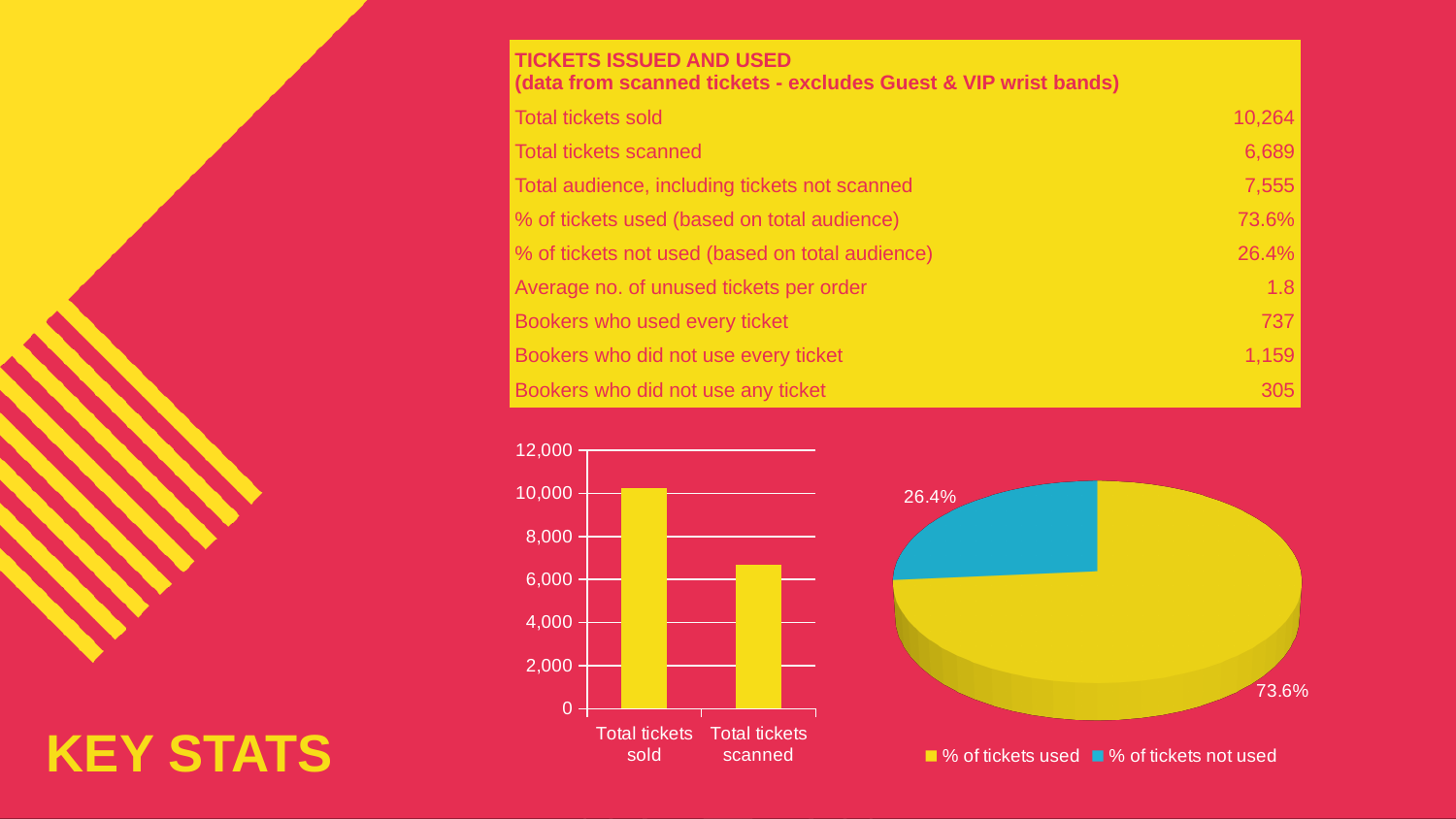
In the bar chart, is the value for Total tickets scanned greater or less than 6,000? greater In the pie chart, how many entries does the legend list? 2 In the bar chart, is the value for Total tickets sold greater or less than 10,000? greater In the pie chart, what colour is the slice for % of tickets not used? blue In the bar chart, which category has the higher value? Total tickets sold In the bar chart, which category has the lower value? Total tickets scanned In the pie chart, what share is labelled for % of tickets not used? 26.4% In the bar chart, is the value for Total tickets scanned greater or less than 8,000? less In the pie chart, what share is labelled for % of tickets used? 73.6% What kind of chart is the chart on the left of the slide? bar chart What kind of chart is the chart on the right of the slide? pie chart In the bar chart, how many categories are shown? 2